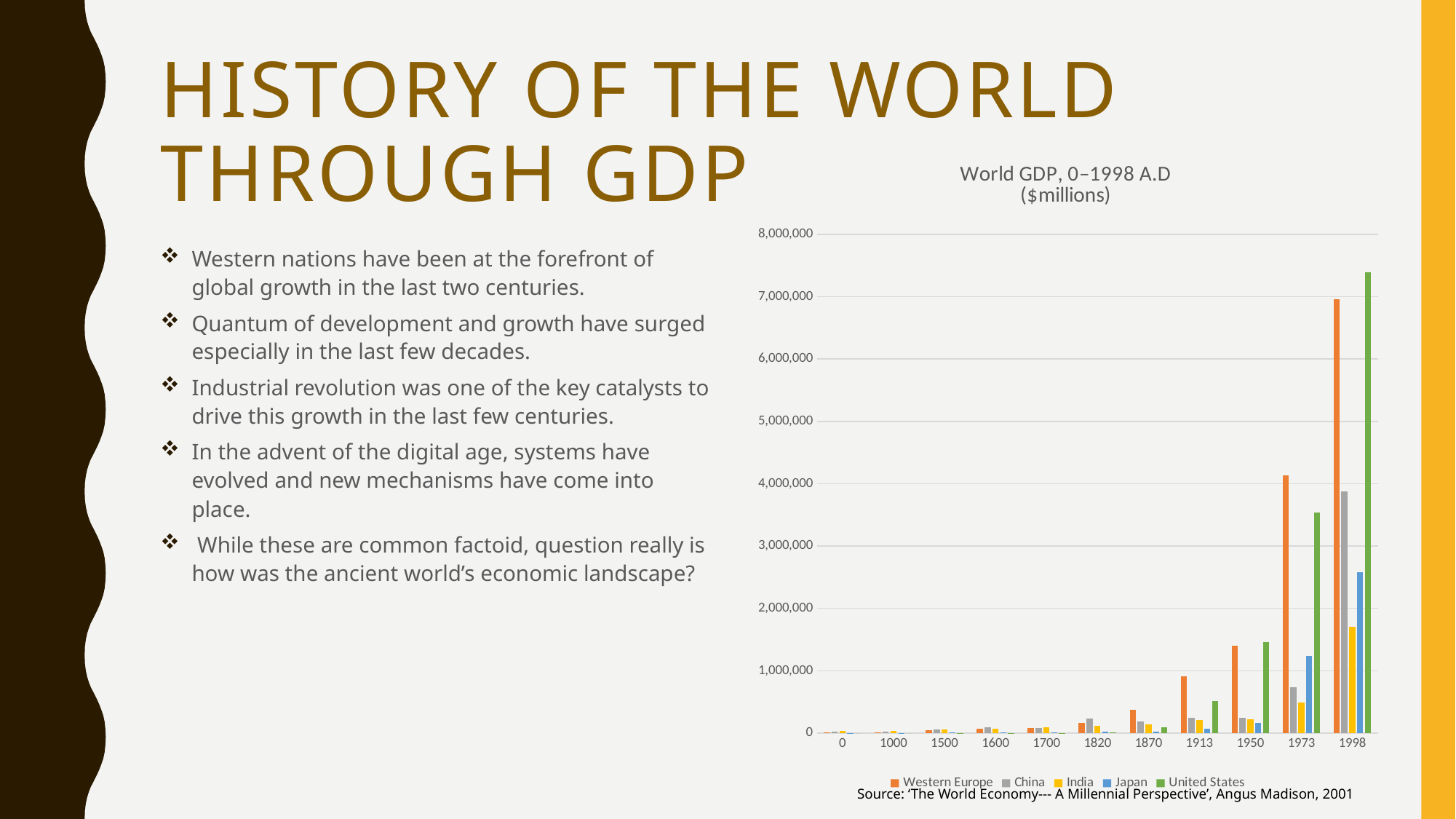
Is the value for India in 1998 greater or less than 2,000,000? less How many series does the chart's legend list? 5 What is the title of the chart? World GDP, 0–1998 A.D ($millions) Which series has the highest value in 1998? United States Is the value for United States in 1998 greater or less than 7,000,000? greater Is the value for Western Europe in 1913 greater or less than 1,000,000? less Which series has the lowest value in 1998? India What type of chart is shown on the slide? bar chart How many year categories are shown on the x axis of the chart? 11 Do the values for Western Europe generally rise or fall from 0 to 1998? rise Which series has the highest value in 1973? Western Europe In 1973, which is larger: the value for China or the value for Japan? Japan